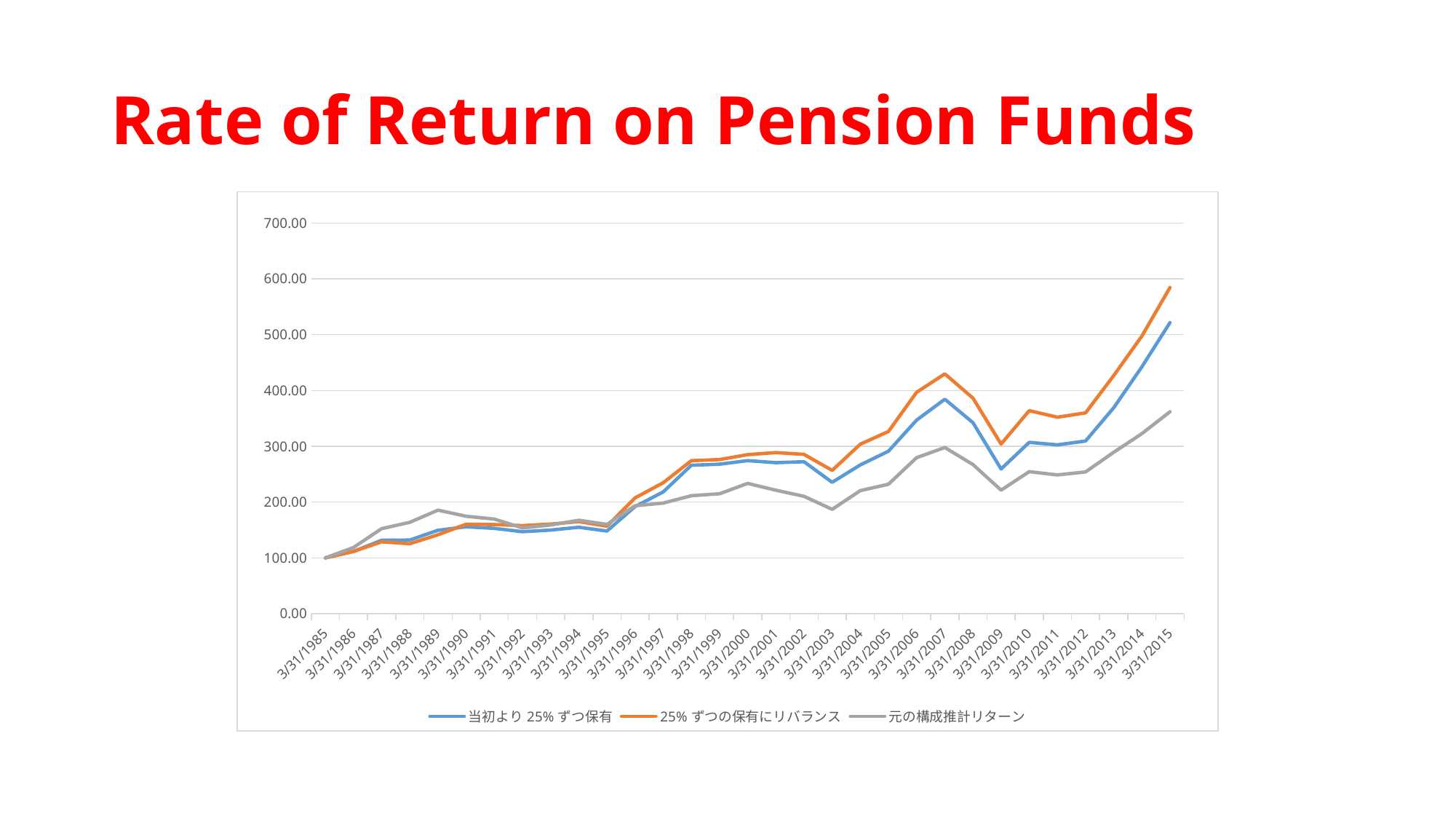
Is the value of the 当初より 25% ずつ保有 series at 3/31/2009 greater or less than 300? less Overall, do the series rise or fall from 3/31/1985 to 3/31/2015? Rise Is the value of the 元の構成推計リターン series at 3/31/2015 greater or less than 400? less What is the title of the slide? Rate of Return on Pension Funds Is the value of the 元の構成推計リターン series at 3/31/2003 greater or less than 200? less Which series is shown in orange in the legend? 25% ずつの保有にリバランス How many dates are shown along the x axis? 31 Which series has the highest value at 3/31/2015? 25% ずつの保有にリバランス What kind of chart is shown on the slide? Line chart How many series does the legend list? 3 At 3/31/1989, which is larger: the 元の構成推計リターン series or the 当初より 25% ずつ保有 series? 元の構成推計リターン